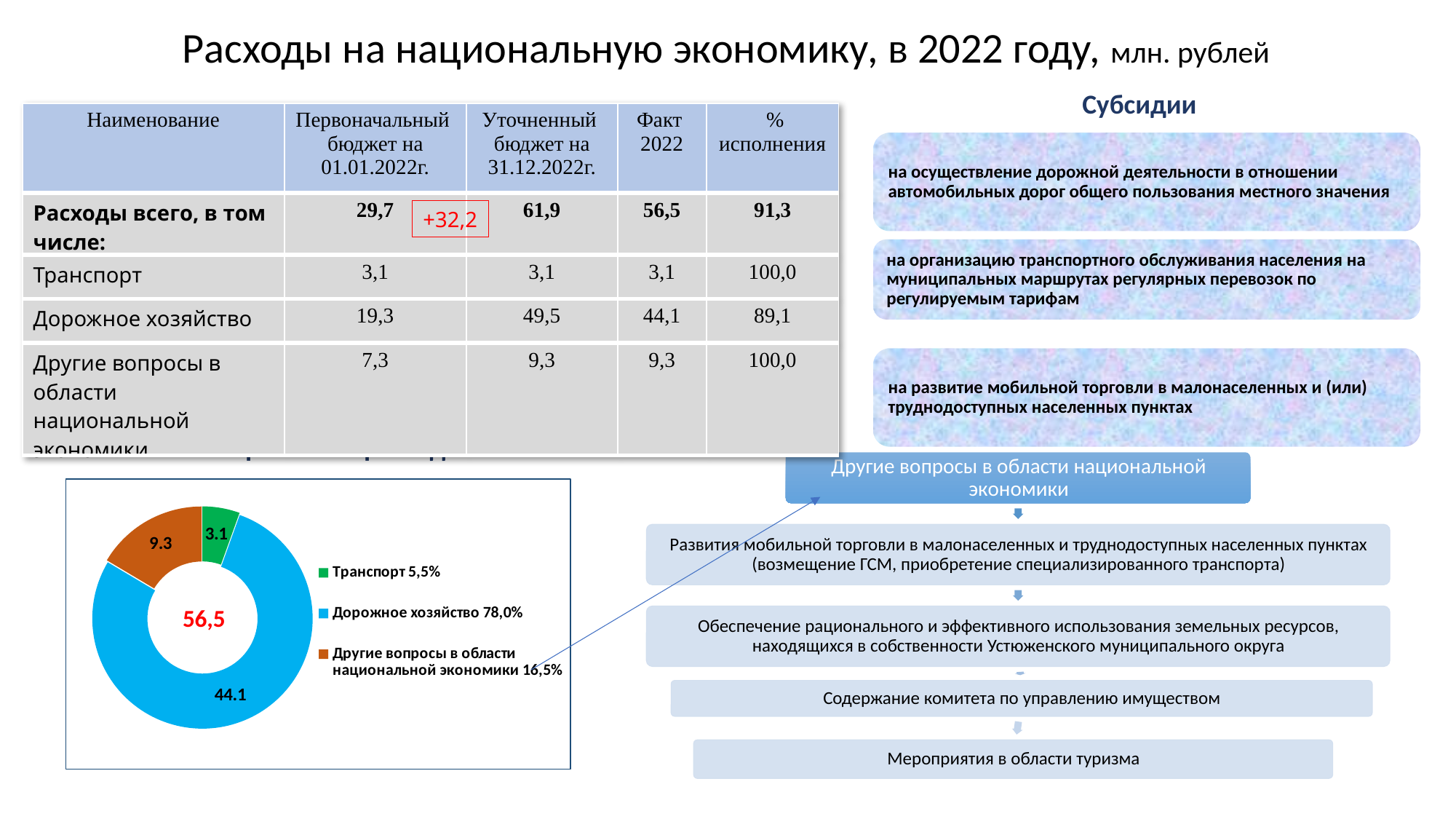
In the doughnut chart, what is the value shown for Транспорт? 3.1 How many categories does the doughnut chart show? 3 What number is printed in the centre of the doughnut chart? 56,5 In the doughnut chart, what is the value shown for Дорожное хозяйство? 44.1 In the doughnut chart, what is the value shown for Другие вопросы в области национальной экономики? 9.3 In the doughnut chart, which is larger: the value for Другие вопросы в области национальной экономики or the value for Транспорт? Другие вопросы в области национальной экономики Which category has the smallest slice in the doughnut chart? Транспорт According to the legend of the doughnut chart, what share does Транспорт have? 5,5% Which category has the largest slice in the doughnut chart? Дорожное хозяйство According to the legend of the doughnut chart, what share does Дорожное хозяйство have? 78,0% In the doughnut chart, what is the difference between the values for Дорожное хозяйство and Другие вопросы в области национальной экономики? 34.8 What kind of chart is shown at the bottom left of the slide? Doughnut (pie) chart